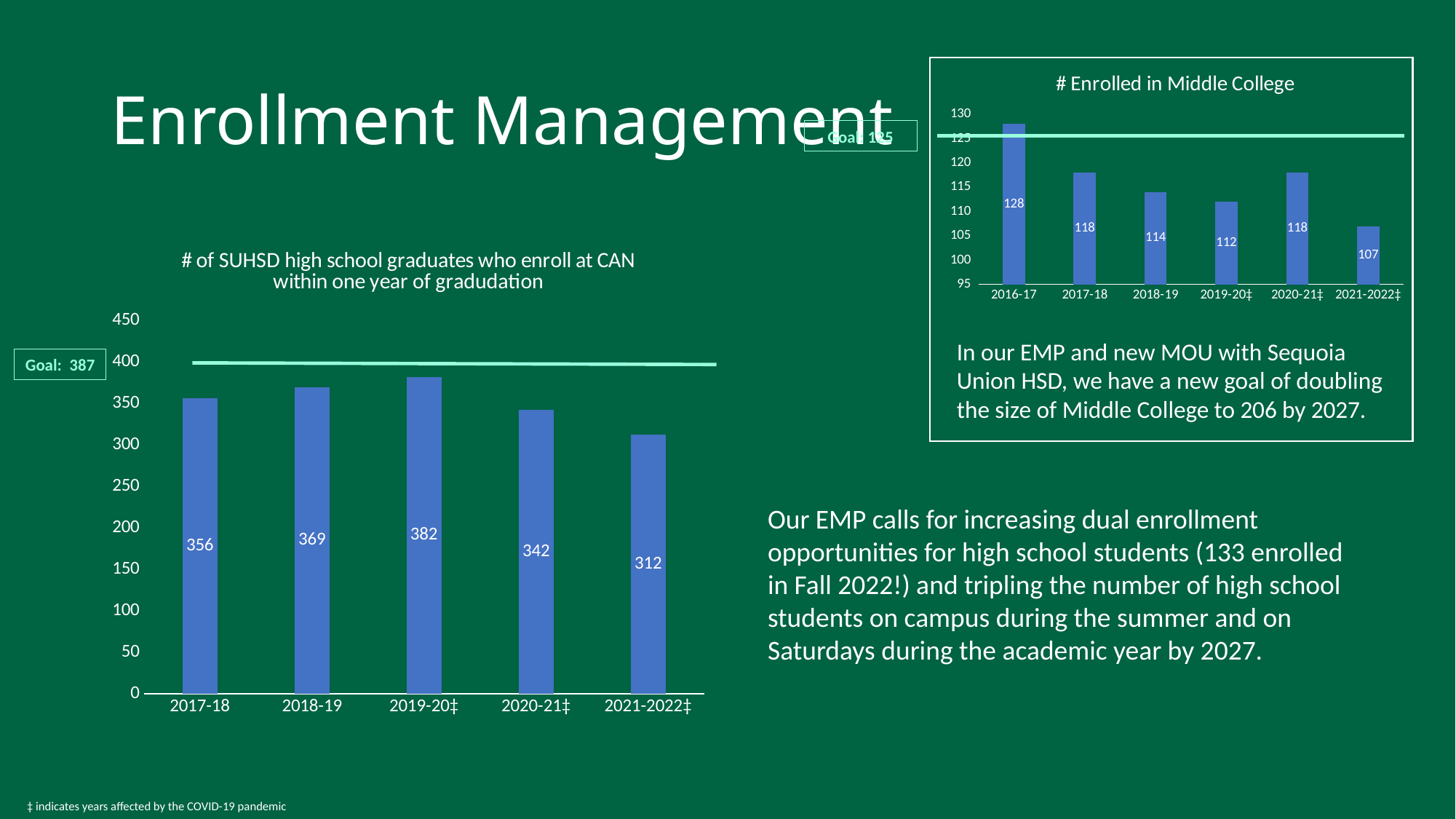
In the chart '# of SUHSD high school graduates who enroll at CAN within one year of gradudation', is the value for 2017-18 greater or less than 400? less In the chart '# of SUHSD high school graduates who enroll at CAN within one year of gradudation', which year has the lowest value? 2021-2022‡ In the chart '# of SUHSD high school graduates who enroll at CAN within one year of gradudation', which year has the highest value? 2019-20‡ In the chart '# of SUHSD high school graduates who enroll at CAN within one year of gradudation', what is the value for 2019-20‡? 382 In the chart '# Enrolled in Middle College', which year has the lowest value? 2021-2022‡ In the chart '# of SUHSD high school graduates who enroll at CAN within one year of gradudation', what is the difference between the 2018-19 and 2020-21‡ values? 27 What kind of chart is '# Enrolled in Middle College'? Bar chart In the chart '# Enrolled in Middle College', which is larger, the value for 2018-19 or the value for 2019-20‡? 2018-19 In the chart '# Enrolled in Middle College', how many years are shown on the x axis? 6 In the chart '# of SUHSD high school graduates who enroll at CAN within one year of gradudation', how many years are shown on the x axis? 5 In the chart '# Enrolled in Middle College', what is the difference between the 2016-17 and 2021-2022‡ values? 21 In the chart '# Enrolled in Middle College', what is the value for 2016-17? 128